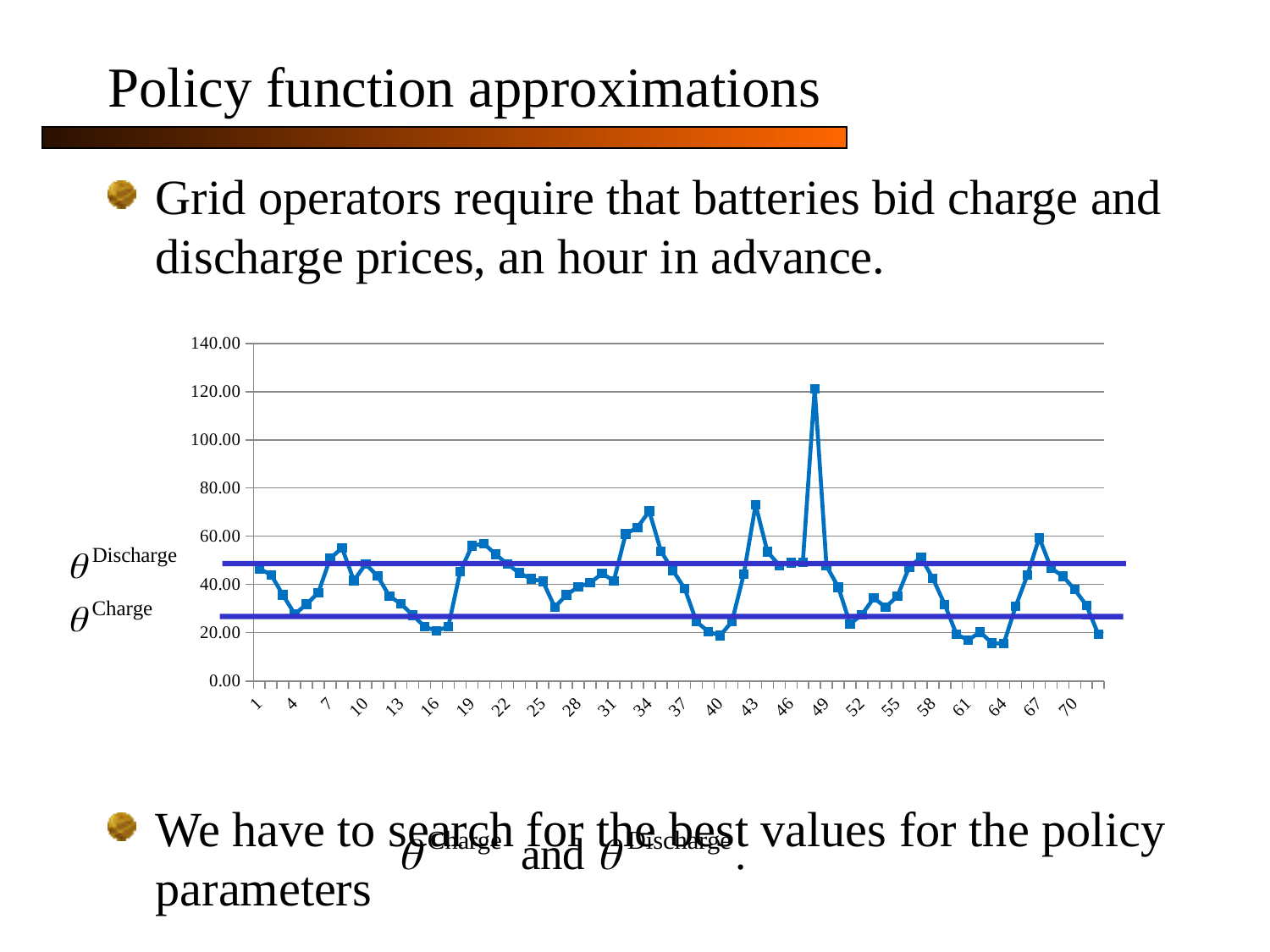
Do the values rise or fall from x = 40 to x = 43? rise What kind of chart is shown on the slide? line chart What is the highest value shown on the y axis of the chart? 140.00 Is the highest point of the line greater or less than 100? greater Which of the two horizontal lines on the chart is higher, the one labelled θ Discharge or the one labelled θ Charge? θ Discharge Is the value at x = 64 greater or less than 20? less What is the lowest value shown on the y axis of the chart? 0.00 Is the value at x = 34 greater or less than 60? greater Do the values rise or fall from x = 1 to x = 4? fall